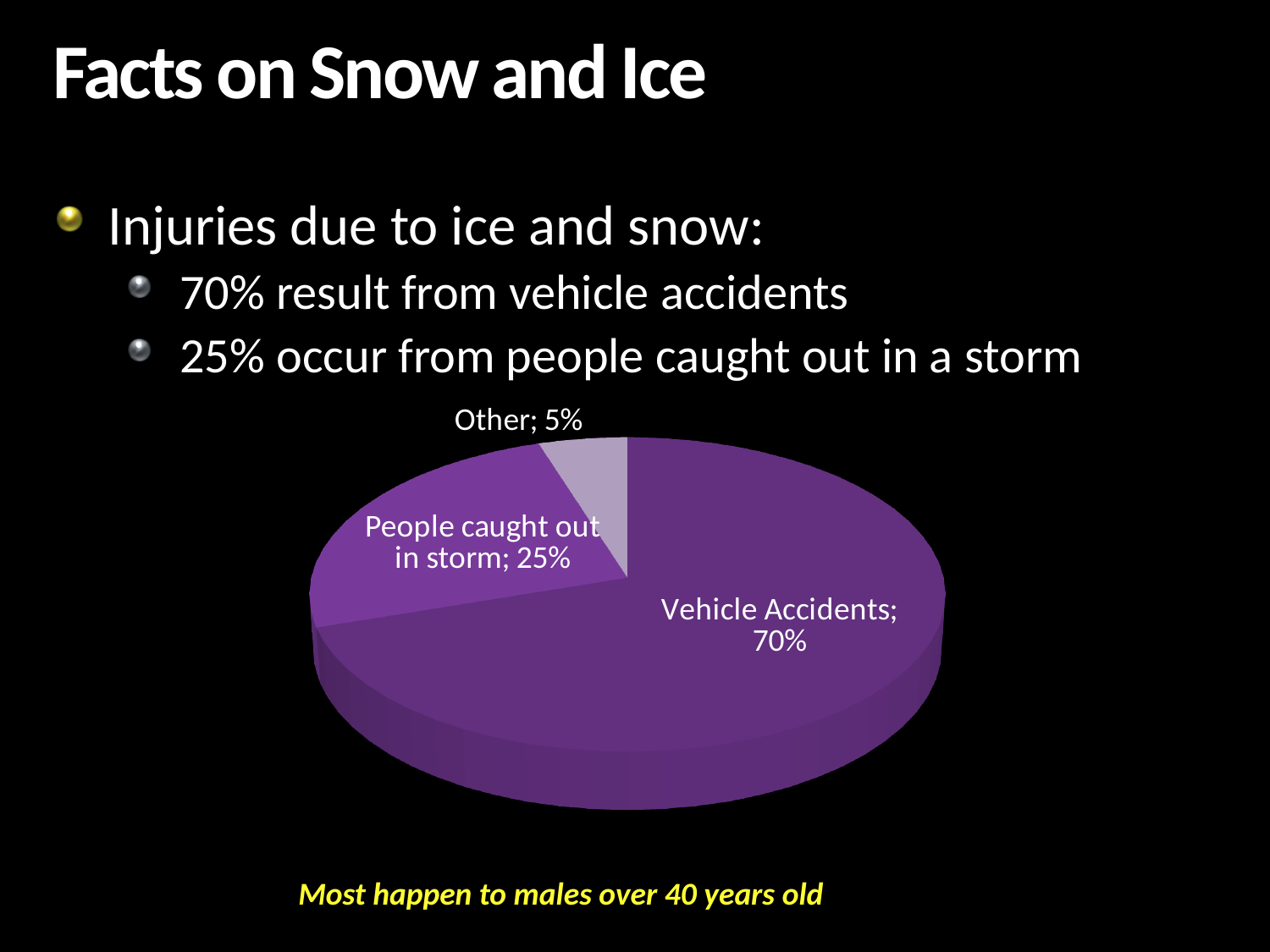
What is the difference in percentage points between Vehicle Accidents and People caught out in storm? 45 What percentage of injuries is attributed to Vehicle Accidents? 70% Which slice of the pie is shown in the lightest shade of purple? Other What kind of chart is shown on the slide? Pie chart What percentage of injuries is attributed to Other? 5% Which category has the smallest slice of the pie? Other What percentage of injuries is attributed to People caught out in storm? 25% Which is larger, the slice for People caught out in storm or the slice for Other? People caught out in storm What is the difference in percentage points between People caught out in storm and Other? 20 How many slices does the pie chart have? 3 Which category has the largest slice of the pie? Vehicle Accidents What share of the pie does the Vehicle Accidents slice represent? 70%